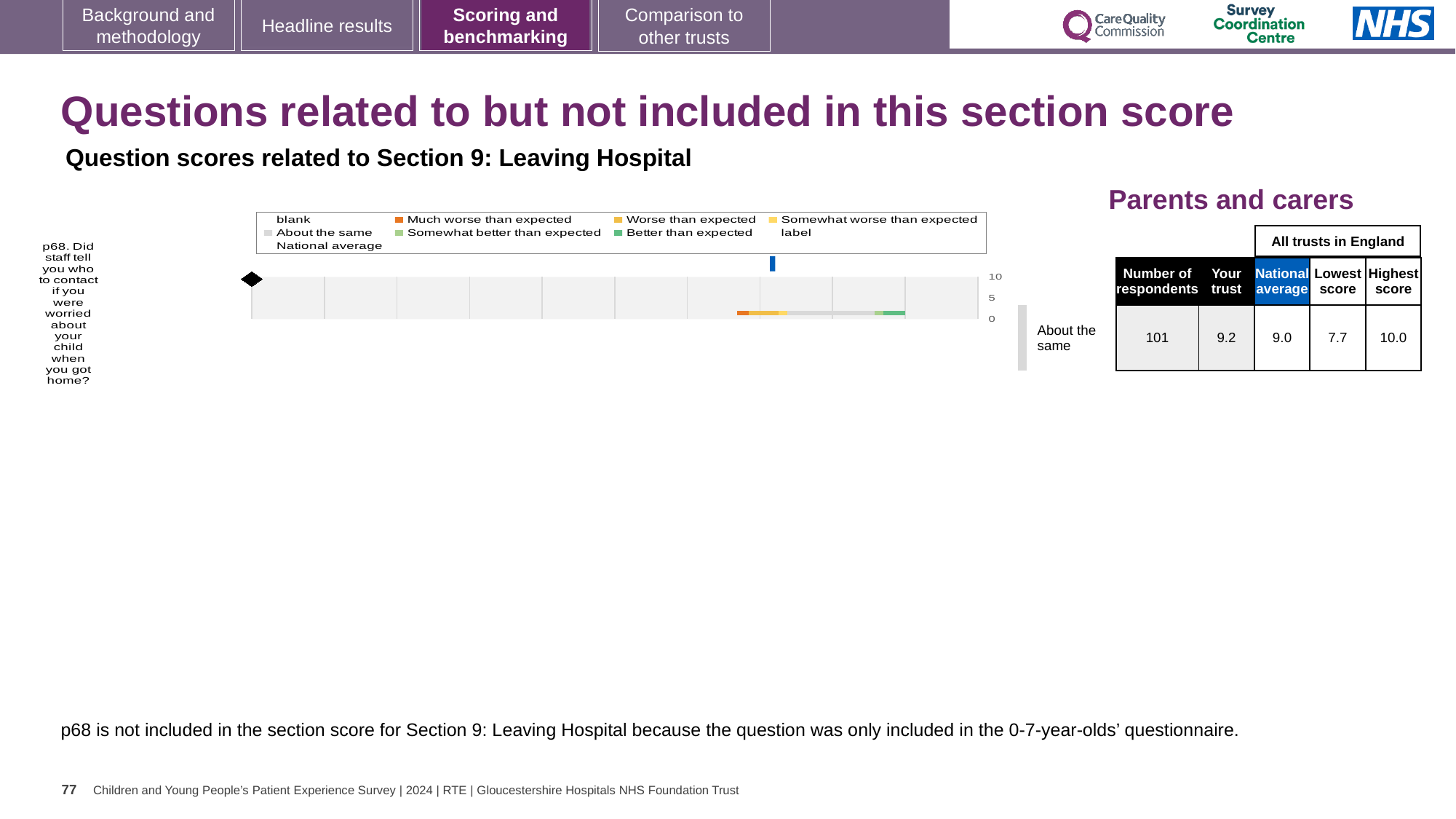
What is the lowest score among all trusts in England for p68? 7.7 What is the difference between the highest score and the lowest score for p68? 2.3 What is the 'Your trust' score for p68 in the table beside the chart? 9.2 What benchmark category is shown for p68 next to the chart? About the same Which question number is plotted in the chart? p68 Which is larger for p68, the 'Your trust' score or the national average? Your trust What is the national average score for p68 in the table beside the chart? 9.0 What colour does the legend use for 'Much worse than expected'? orange How many respondents answered p68? 101 What kind of chart is shown on the slide? bar chart What is the highest score among all trusts in England for p68? 10.0 Is the 'Your trust' score for p68 greater or less than 5? greater